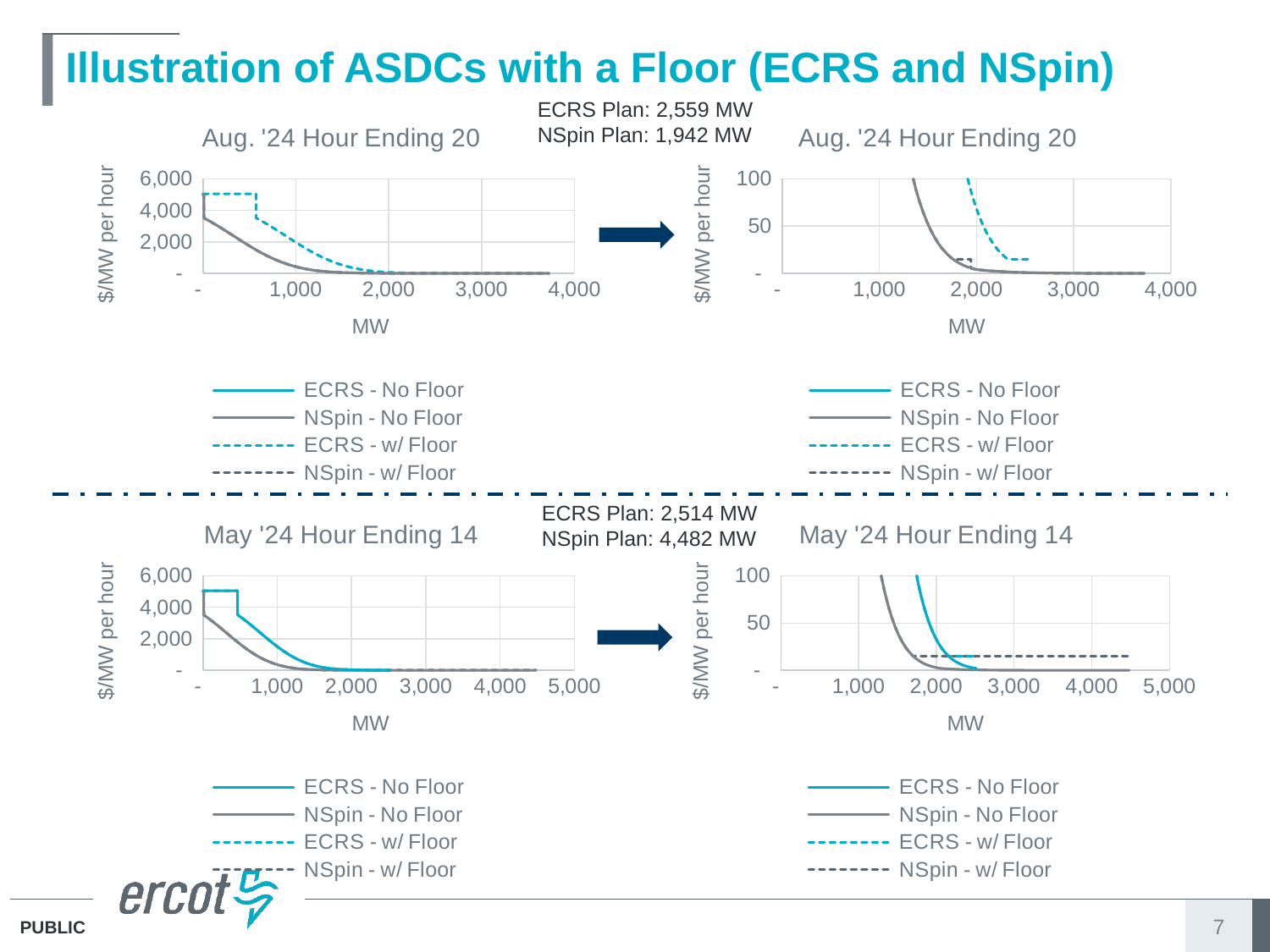
What is the highest tick value on the x axis of the bottom-left chart (May '24 Hour Ending 14)? 5,000 What kind of chart is the top-left chart titled "Aug. '24 Hour Ending 20"? Line chart In the top-left chart (Aug. '24 Hour Ending 20), what is the label on the y axis? $/MW per hour What is the highest tick value on the y axis of the top-right chart (Aug. '24 Hour Ending 20)? 100 In the top-left chart (Aug. '24 Hour Ending 20), is the starting value of the ECRS - w/ Floor series at 0 MW greater or less than 4,000? greater What is the NSpin Plan value shown between the two May '24 Hour Ending 14 charts? 4,482 MW In the top-left chart (Aug. '24 Hour Ending 20), do the plotted values rise or fall as MW increases? Fall In the bottom-right chart (May '24 Hour Ending 14), what is the label on the x axis? MW What is the ECRS Plan value shown between the two Aug. '24 Hour Ending 20 charts? 2,559 MW How many series does the legend list for the bottom-left chart titled "May '24 Hour Ending 14"? 4 In the bottom-left chart (May '24 Hour Ending 14), is the starting value of the NSpin - No Floor series at 0 MW greater or less than 4,000? less In the bottom-left chart (May '24 Hour Ending 14), which series starts higher at 0 MW: ECRS - No Floor or NSpin - No Floor? ECRS - No Floor